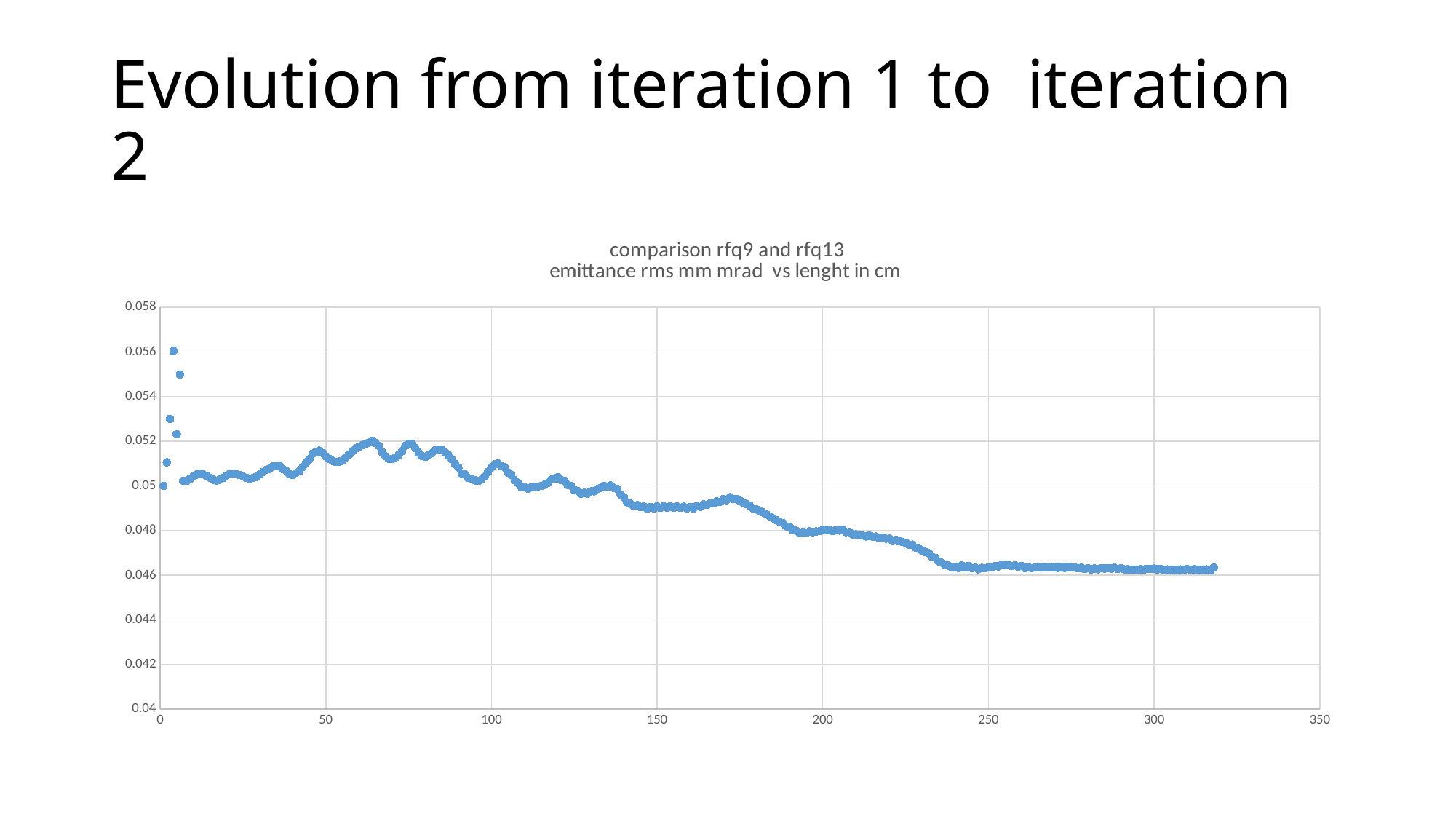
Is the value at a length of 150 cm greater or less than 0.05? less Which is larger, the value at a length of 100 cm or the value at a length of 300 cm? 100 cm Is the value at a length of 100 cm greater or less than 0.054? less What is the title of the chart? comparison rfq9 and rfq13 emittance rms mm mrad vs lenght in cm Which is larger, the value at a length of 175 cm or the value at a length of 225 cm? 175 cm Overall, do the plotted values rise or fall as length increases from 0 to about 320 cm? fall Is the value at a length of 300 cm greater or less than 0.048? less Which is larger, the value at a length of 50 cm or the value at a length of 250 cm? 50 cm What kind of chart is shown on the slide? scatter chart What is the highest value shown on the chart's vertical axis? 0.058